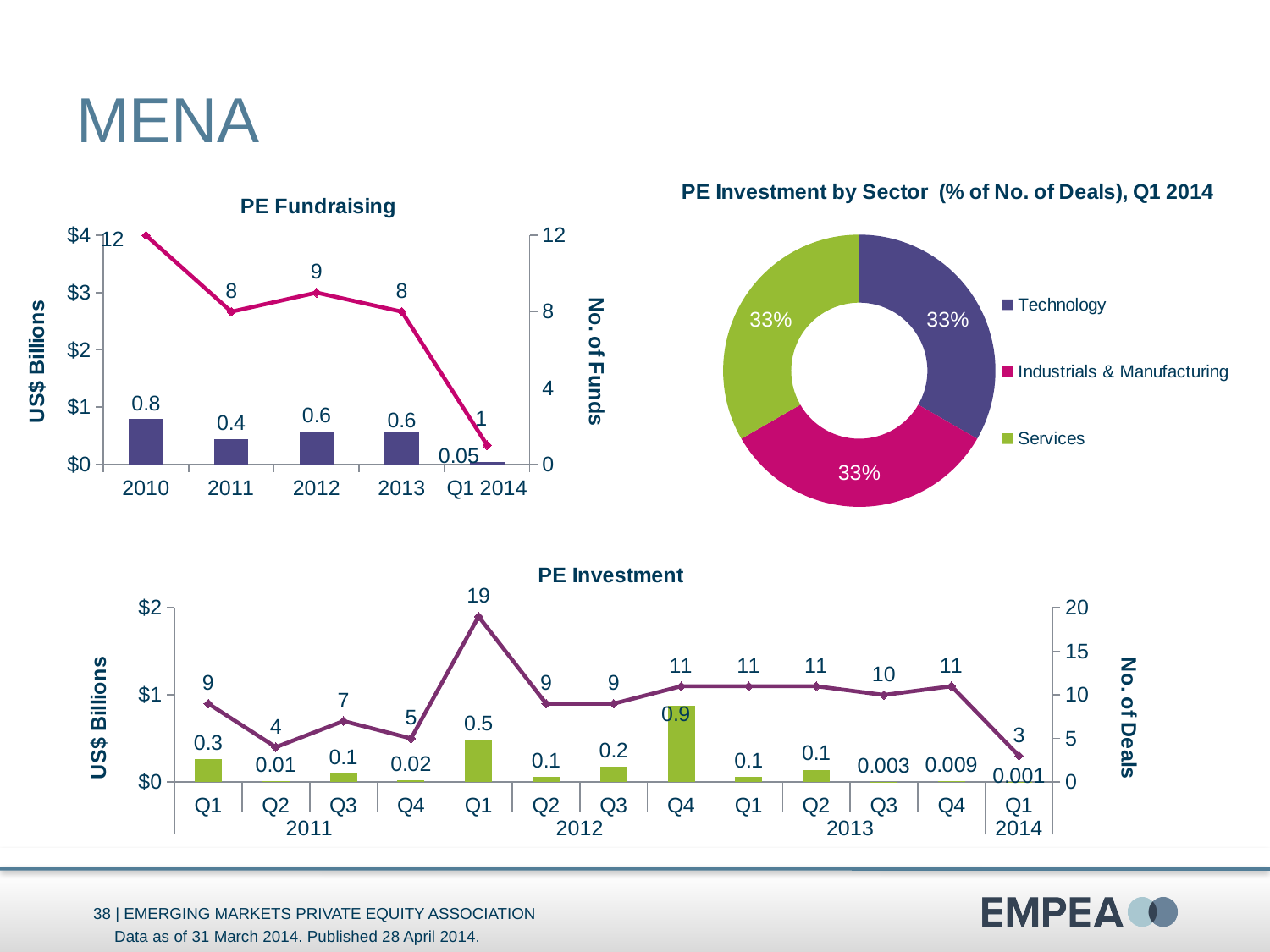
What type of chart is the PE Investment by Sector chart? Pie (donut) chart In the PE Investment chart, what was the investment value in US$ billions for Q1 2014? 0.001 In the PE Investment chart, which had more deals, Q2 2011 or Q3 2011? Q3 2011 In the PE Investment by Sector chart, how many sectors does the legend list? 3 In the PE Fundraising chart, which year had the highest number of funds? 2010 In the PE Investment chart, which quarter had the highest investment value in US$ billions? Q4 2012 In the PE Fundraising chart, how many categories are shown on the x axis? 5 In the PE Fundraising chart, what is the difference in US$ billions between fundraising in 2010 and 2011? 0.4 In the PE Fundraising chart, what was the fundraising value in US$ billions for 2010? 0.8 In the PE Fundraising chart, how many funds were raised in 2012? 9 In the PE Investment chart, what was the number of deals in Q1 2012? 19 In the PE Investment by Sector chart, what share of deals was in Services? 33%